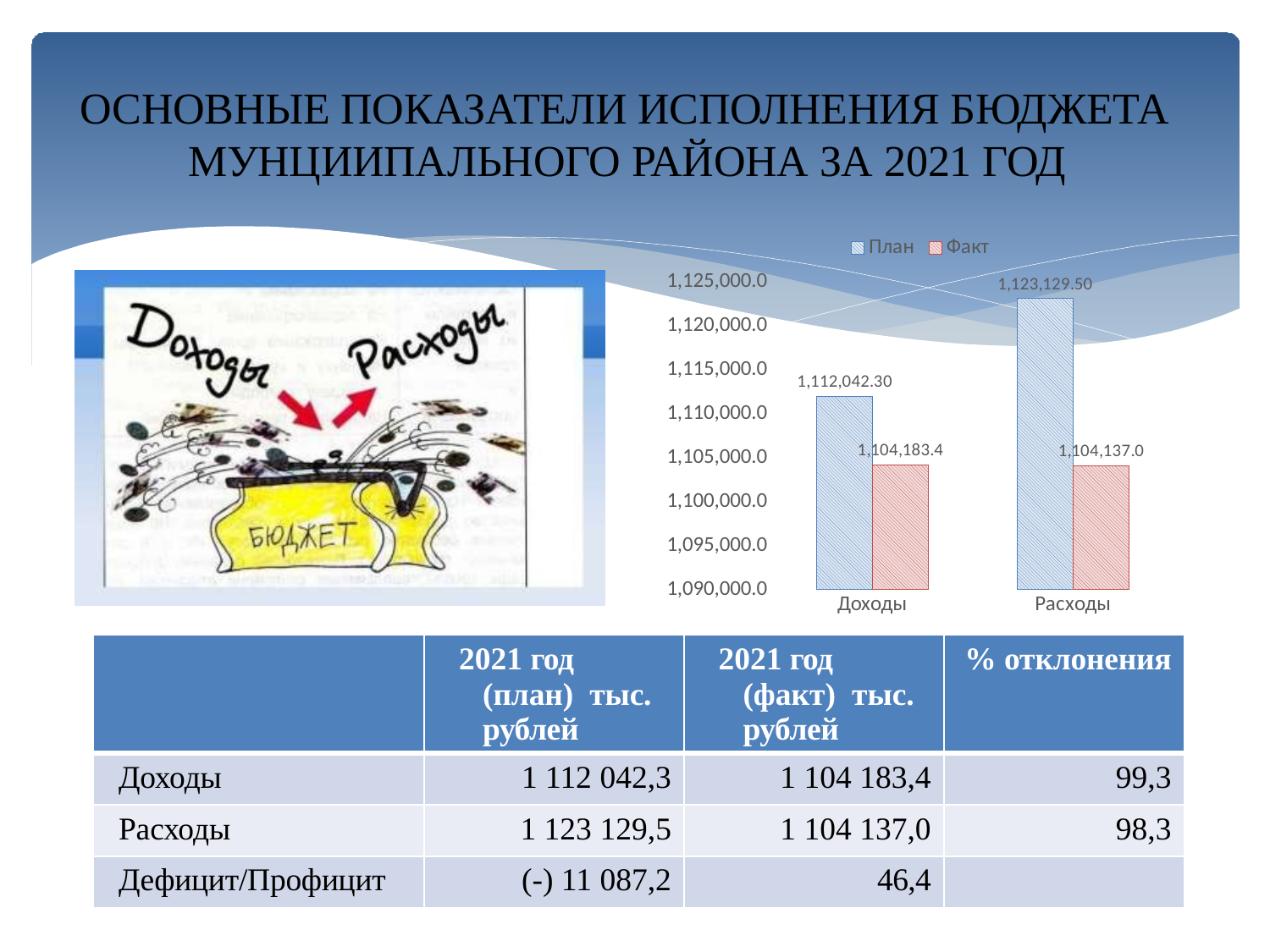
How many series does the chart legend list? 2 Which is larger in the chart: the План value for Расходы or the План value for Доходы? План for Расходы Is the План value for Расходы greater or less than 1,120,000.0? greater What is the Факт value for Доходы in the chart? 1,104,183.4 Which bar in the chart has the highest value? План for Расходы What type of chart is shown on the slide? bar chart What is the План value for Расходы in the chart? 1,123,129.50 What is the План value for Доходы in the chart? 1,112,042.30 What is the Факт value for Расходы in the chart? 1,104,137.0 What is the difference between the План and Факт values for Расходы in the chart? 18,992.5 What are the two legend entries of the chart? План and Факт How many categories are shown on the x axis of the chart? 2